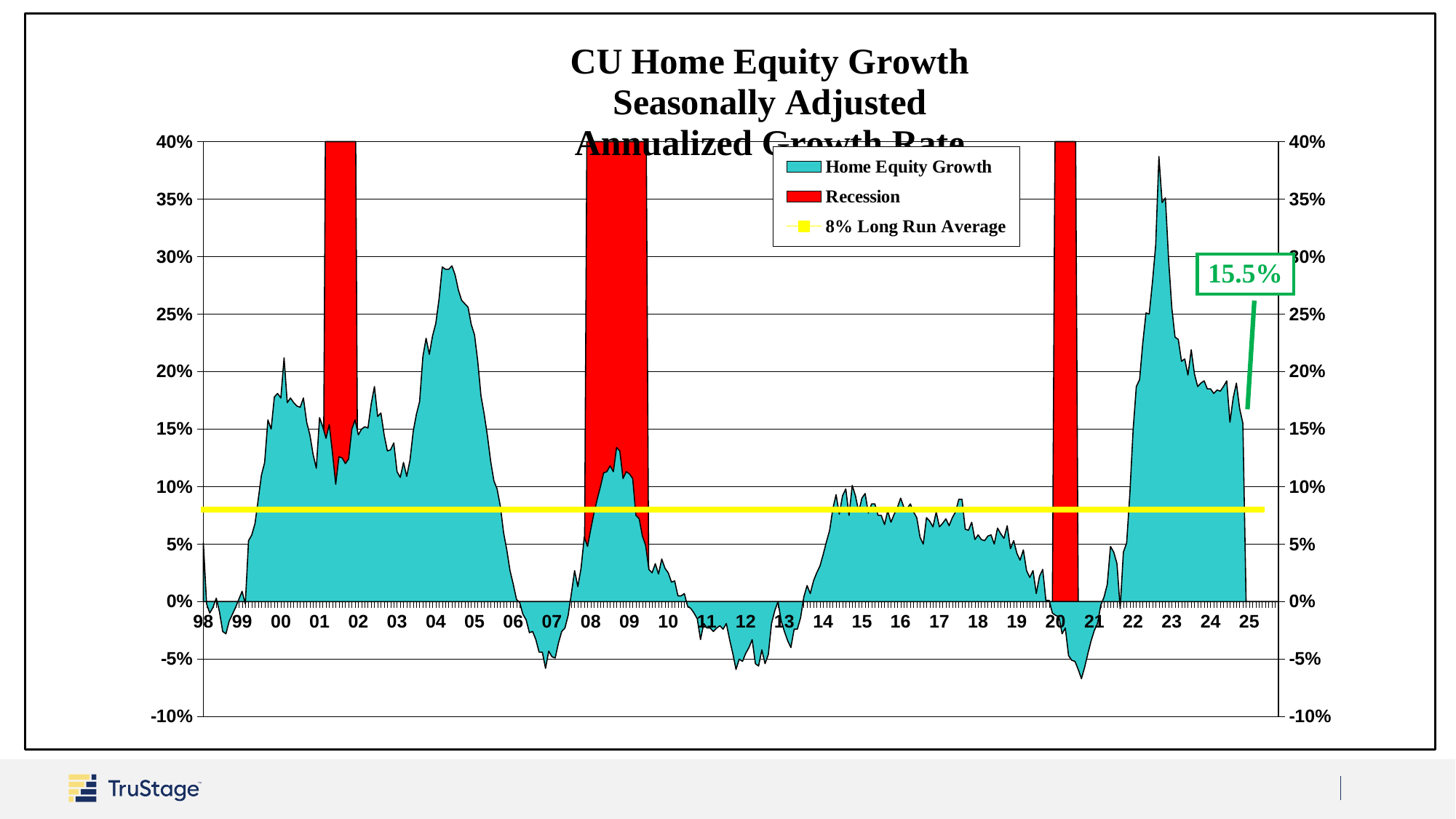
Is the Home Equity Growth value in 2017 greater or less than 10%? less Is the Home Equity Growth value in 2012 greater or less than 0%? less Is the peak Home Equity Growth value around 2022-23 greater or less than 35%? greater What colour are the recession bars on the chart? red What is the lowest value shown on the vertical axis? -10% Does Home Equity Growth rise or fall from 2023 to 2024? fall What value does the long run average line represent, according to the legend? 8% Which is larger, the Home Equity Growth value in 2004 or in 2012? 2004 How many recession periods are shaded on the chart? 3 What kind of chart is shown on the slide? area chart How many series does the legend list? 3 What is the latest Home Equity Growth value highlighted in the callout box? 15.5%